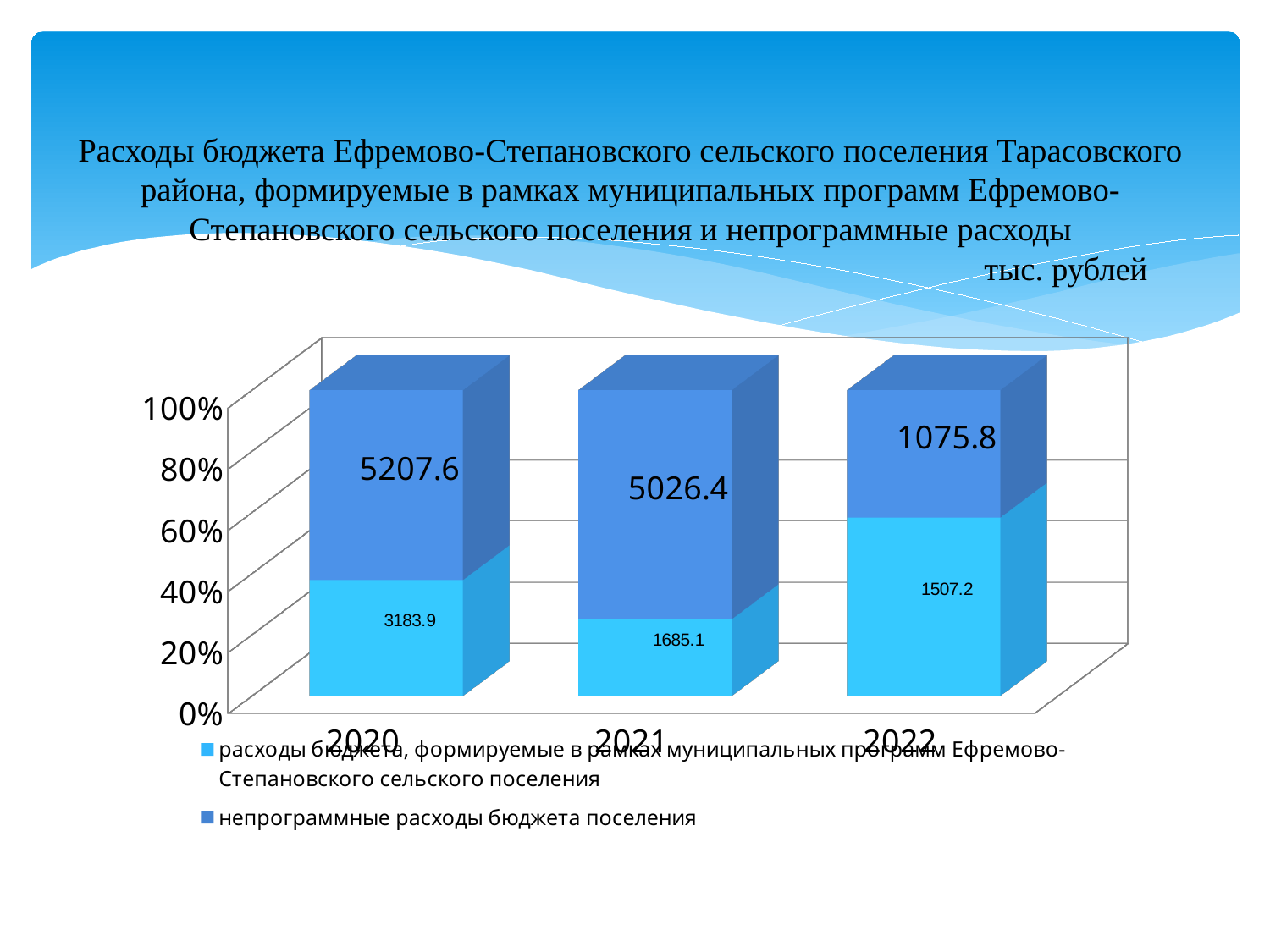
In which year are program-based budget expenditures the lowest? 2022 What is the value of non-program budget expenditures (непрограммные расходы бюджета поселения) for 2020? 5207.6 How many series does the legend list? 2 What is the total of the two series for 2022? 2583.0 How many years (categories) are shown on the x axis? 3 What is the value of non-program budget expenditures for 2022? 1075.8 What is the value of program-based budget expenditures (расходы бюджета, формируемые в рамках муниципальных программ) for 2021? 1685.1 In which year are non-program budget expenditures the highest? 2020 Which is larger in 2022: program-based expenditures or non-program expenditures? program-based expenditures (1507.2) What is the difference between non-program expenditures in 2020 and 2021? 181.2 What kind of chart is shown on the slide? stacked bar chart What is the value of program-based budget expenditures for 2022? 1507.2